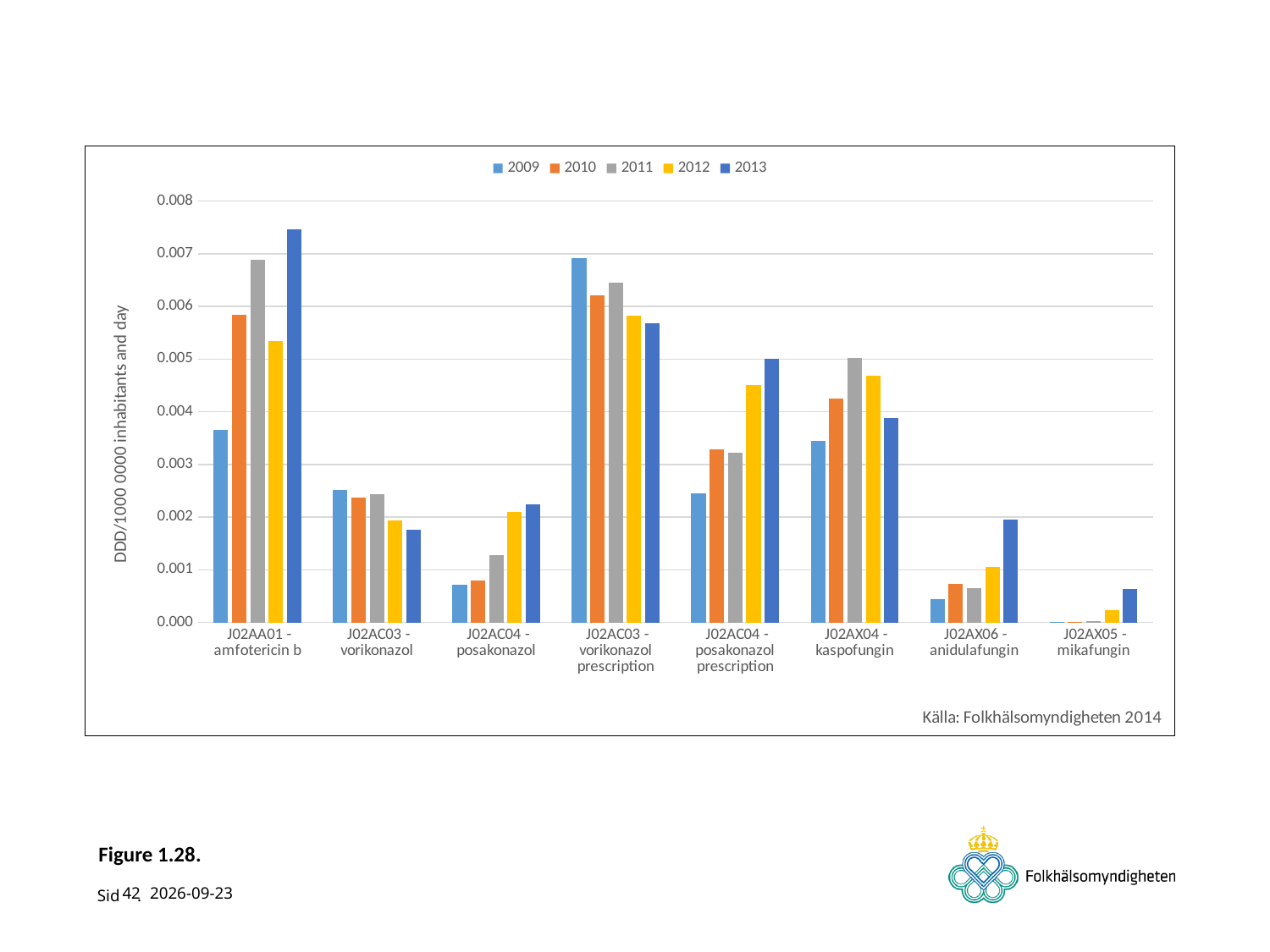
Do the values for J02AC04 - posakonazol rise or fall from 2009 to 2013? rise Which category has the lowest value for 2013? J02AX05 - mikafungin For J02AA01 - amfotericin b, which year has the highest value? 2013 Is the 2013 value for J02AA01 - amfotericin b greater or less than 0.007? greater Which is larger for 2013: J02AX04 - kaspofungin or J02AC04 - posakonazol prescription? J02AC04 - posakonazol prescription What kind of chart is shown on the slide? bar chart What is the label on the y axis? DDD/1000 0000 inhabitants and day How many series does the legend list? 5 Is the 2012 value for J02AC04 - posakonazol prescription greater or less than 0.004? greater Is the 2009 value for J02AC03 - vorikonazol prescription greater or less than 0.006? greater Which category has the highest value for 2013? J02AA01 - amfotericin b How many drug categories are shown on the x axis? 8